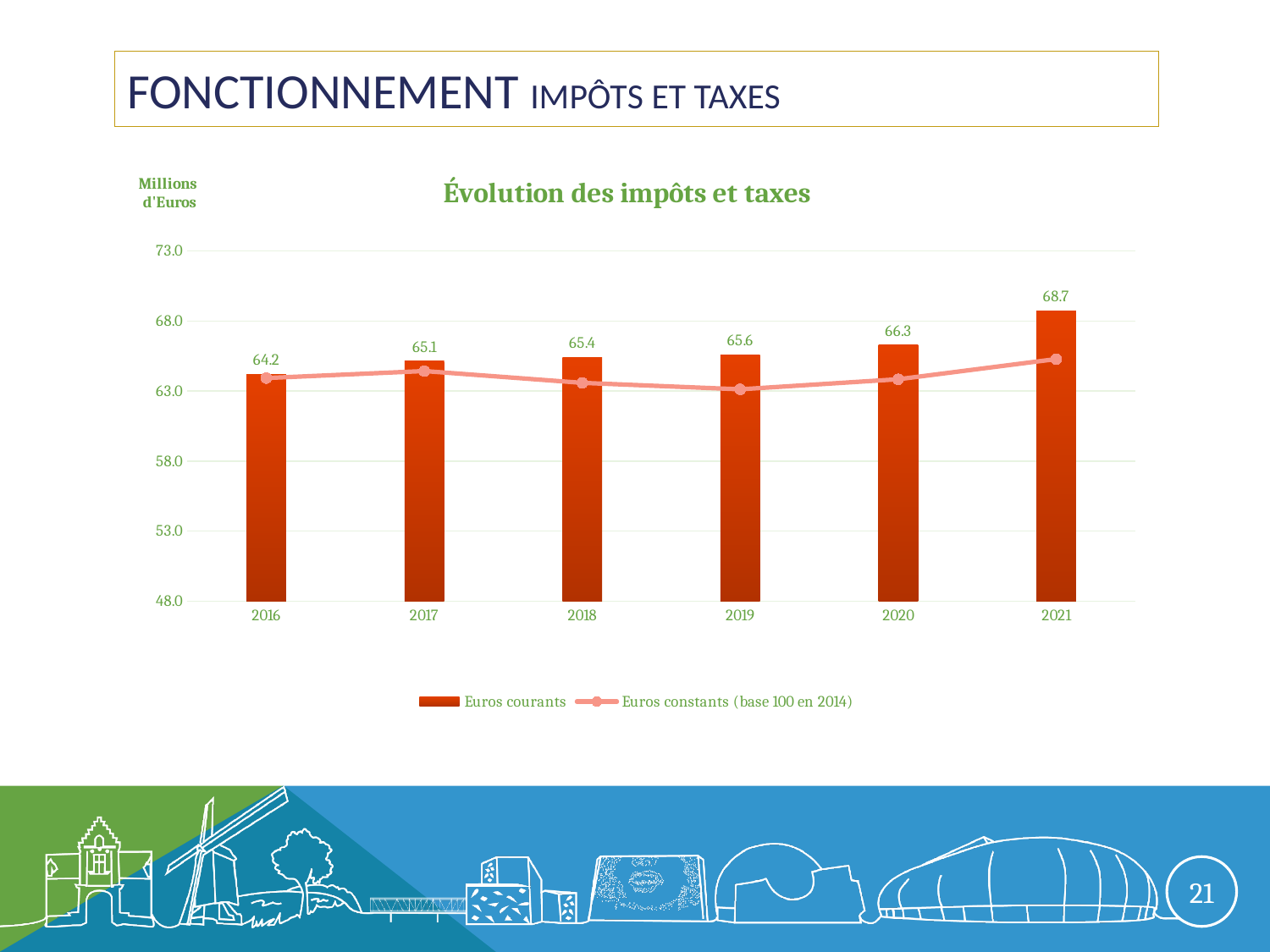
How many years are shown on the x axis? 6 How many series does the legend list? 2 Which year has the lowest value for Euros courants? 2016 What is the value of Euros courants for 2016? 64.2 Which year has the highest value for Euros courants? 2021 What is the difference between the Euros courants values for 2021 and 2020? 2.4 What is the value of Euros courants for 2021? 68.7 What is the title of the chart? Évolution des impôts et taxes Is the Euros constants value for 2019 greater or less than 68.0? less Do the Euros courants values rise or fall from 2016 to 2021? rise Which is larger, the Euros courants value for 2018 or for 2017? 2018 What is the value of Euros courants for 2019? 65.6